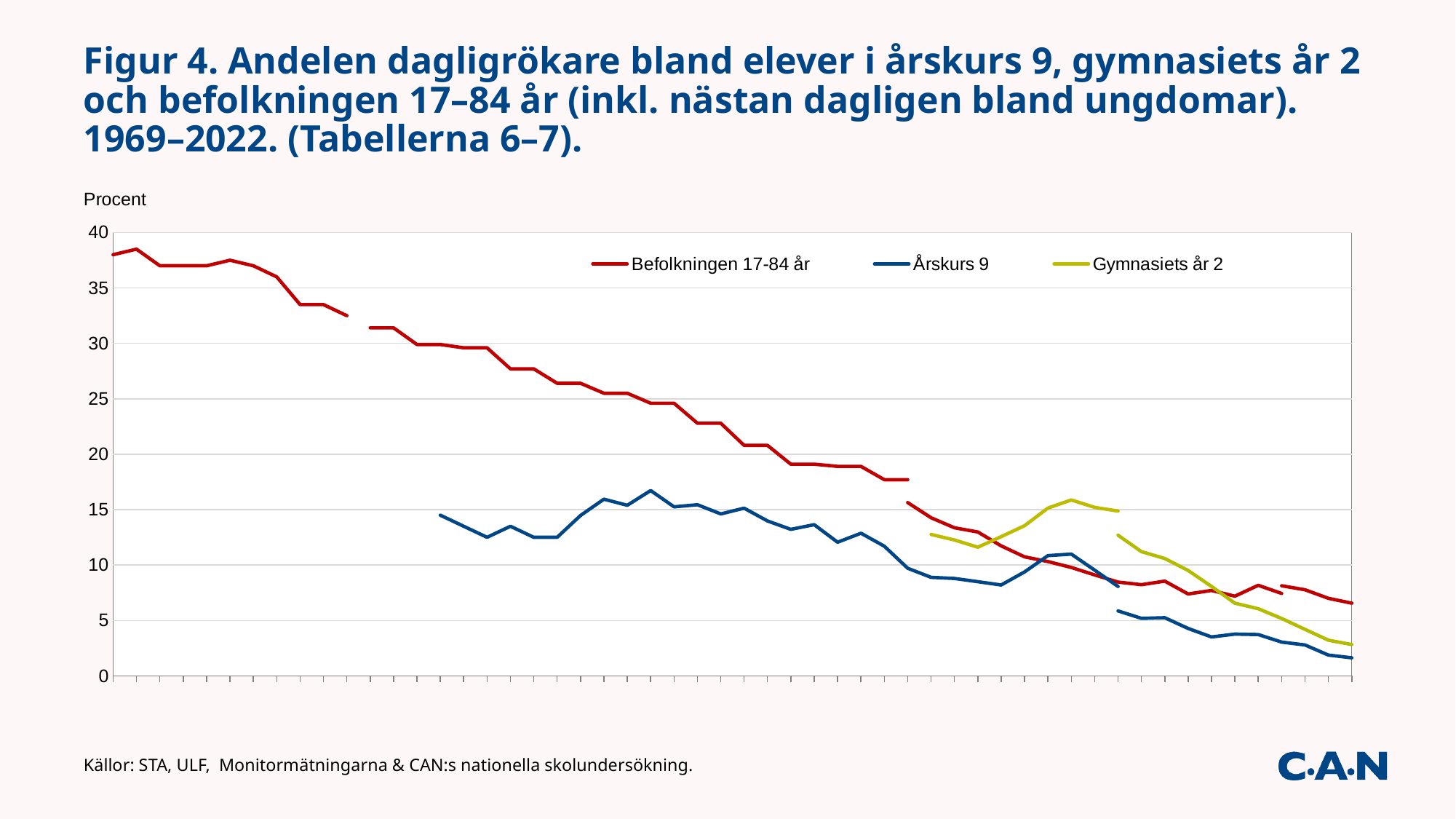
At the right end of the chart, which series is higher: Befolkningen 17-84 år or Årskurs 9? Befolkningen 17-84 år Is the last value of the Befolkningen 17-84 år series greater or less than 10? less Which series are listed in the legend? Befolkningen 17-84 år, Årskurs 9, Gymnasiets år 2 Is the highest value of the Gymnasiets år 2 series greater or less than 15? greater Does the Årskurs 9 series rise or fall overall from left to right? fall Is the last value of the Årskurs 9 series greater or less than 5? less What label is shown on the vertical axis of the chart? Procent Does the Befolkningen 17-84 år series rise or fall overall from left to right? fall Which series reaches the highest value anywhere on the chart? Befolkningen 17-84 år How many series does the legend list? 3 What kind of chart is shown on the slide? line chart